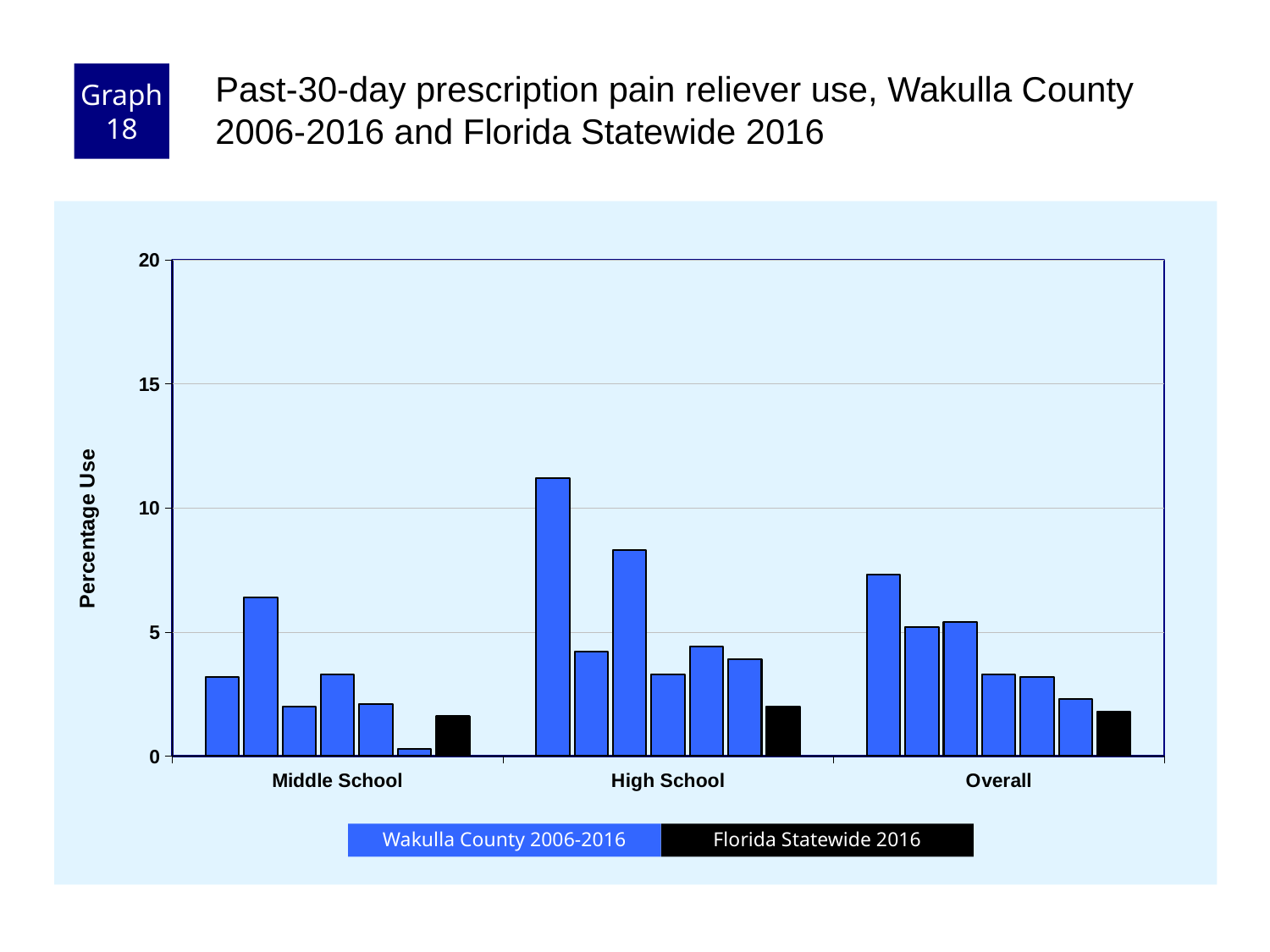
What kind of chart is shown on the slide? bar chart Across the Wakulla County bars in the Overall group, do the values generally rise or fall from left to right? fall How many category groups are shown along the x axis? 3 Is the Florida Statewide 2016 value for High School greater or less than 5? less Is the tallest Wakulla County bar in the High School group greater or less than 10? greater Which category group contains the shortest bar on the chart? Middle School How many series does the legend list? 2 Which category group contains the tallest bar on the chart? High School What is the label on the y axis? Percentage Use In the Overall group, is the Florida Statewide 2016 bar higher or lower than the first Wakulla County bar? lower What are the two series named in the legend? Wakulla County 2006-2016 and Florida Statewide 2016 Is the Florida Statewide 2016 value for Middle School greater or less than 5? less